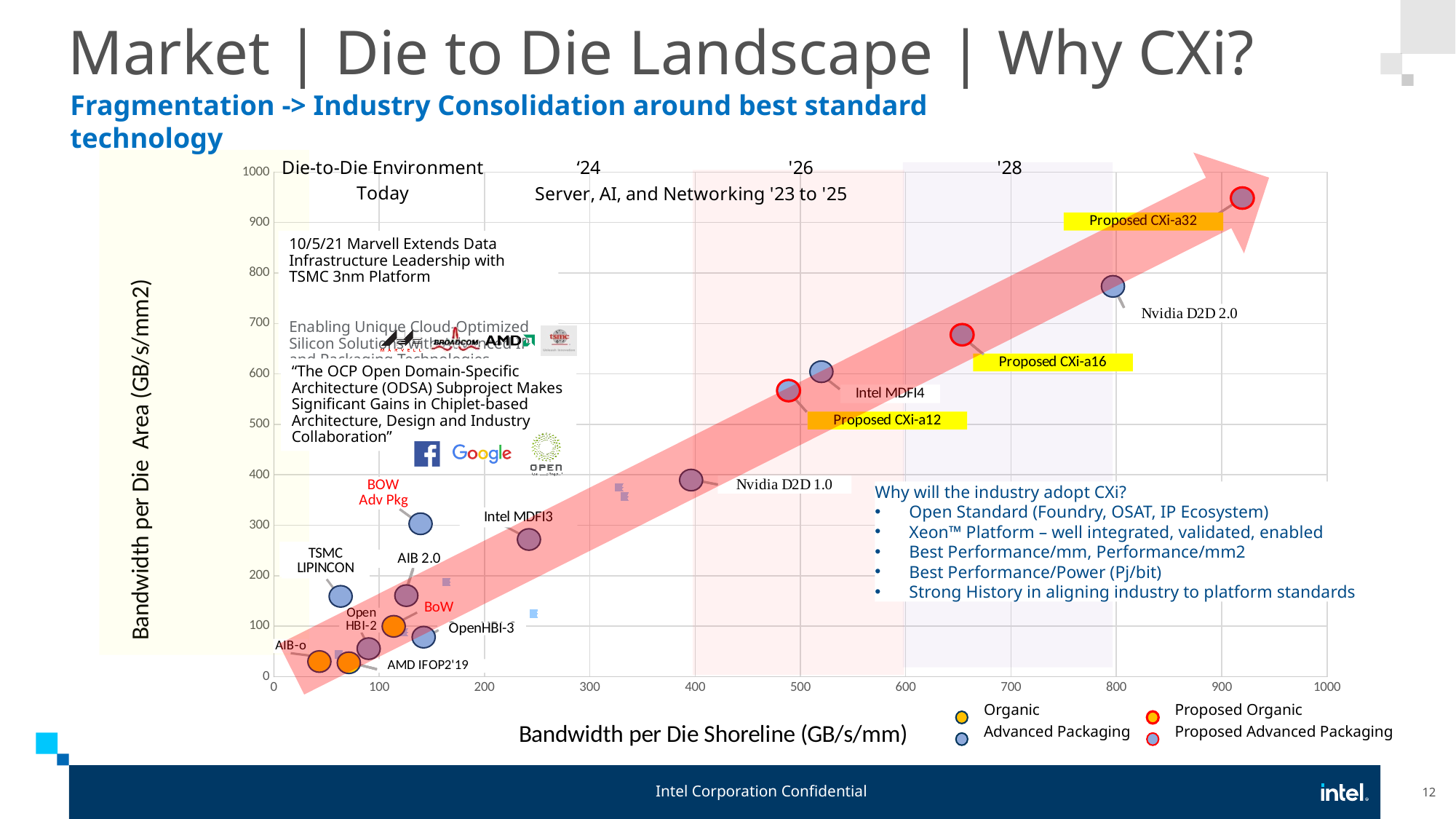
What kind of chart is shown on the slide? scatter chart Is the Bandwidth per Die Area for Nvidia D2D 2.0 greater or less than 700? greater Is the Bandwidth per Die Shoreline for Proposed CXi-a16 greater or less than 600? greater Is the Bandwidth per Die Area for Intel MDFI3 greater or less than 300? less What is the label of the y axis of the chart? Bandwidth per Die Area (GB/s/mm2) Which labelled point has the lowest Bandwidth per Die Shoreline? AIB-o Which has the higher Bandwidth per Die Area, Nvidia D2D 2.0 or Proposed CXi-a16? Nvidia D2D 2.0 What is the label of the x axis of the chart? Bandwidth per Die Shoreline (GB/s/mm) How many entries does the chart's legend list? 4 Do the plotted points generally rise or fall as Bandwidth per Die Shoreline increases along the x axis? rise Which labelled point has the highest Bandwidth per Die Area? Proposed CXi-a32